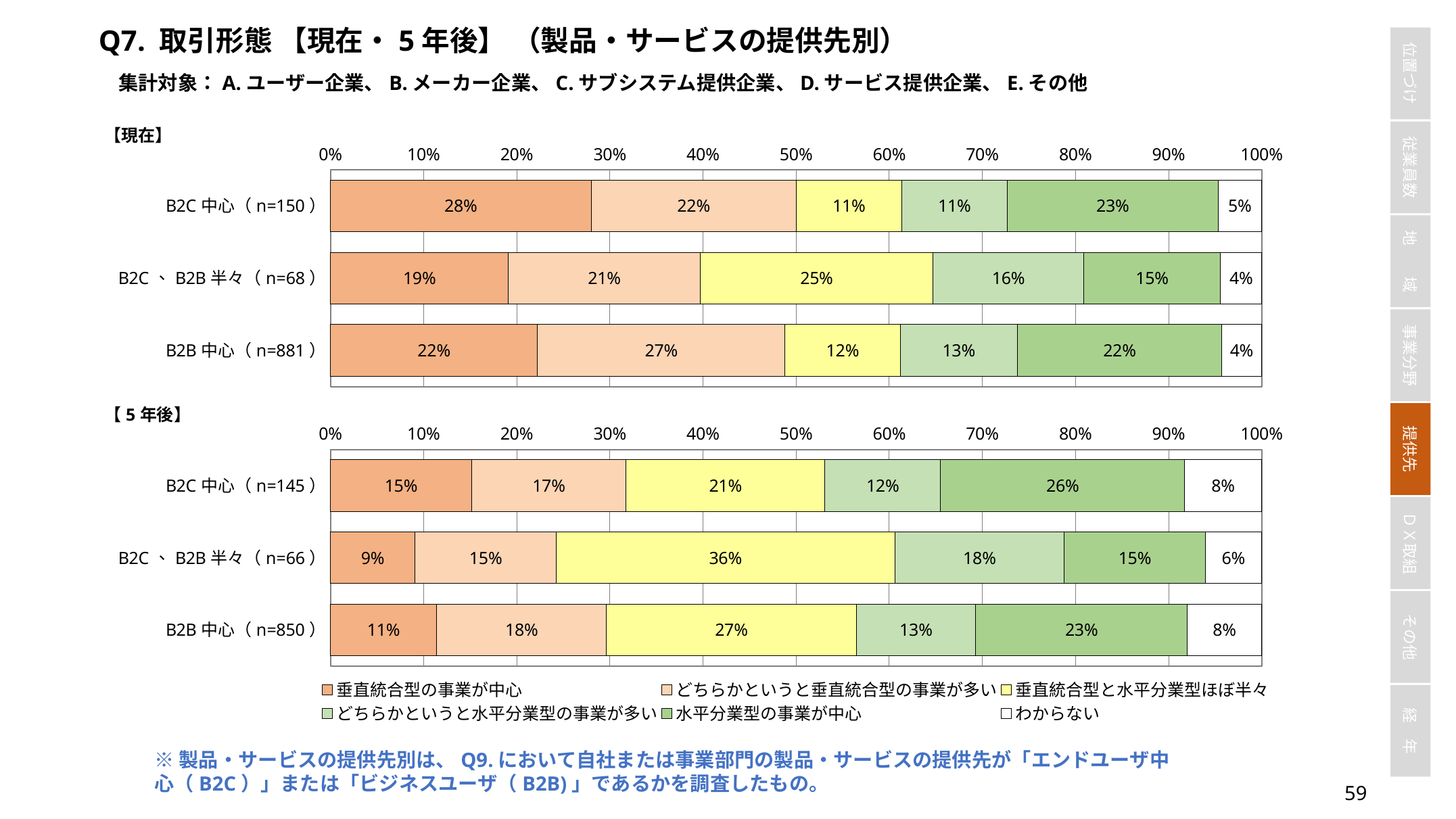
In the 【5年後】 chart, what is the difference between the 垂直統合型と水平分業型ほぼ半々 values for B2C、B2B半々（n=66） and B2B中心（n=850）? 9% In the 【現在】 chart, which category has the lowest value for 垂直統合型の事業が中心? B2C、B2B半々（n=68） In the 【5年後】 chart, what is the combined value of 垂直統合型の事業が中心 and どちらかというと垂直統合型の事業が多い for B2C中心（n=145）? 32% Which legend entry is shown in white? わからない In the 【現在】 chart, what is the value of わからない for B2B中心（n=881）? 4% In the 【現在】 chart, which is larger for B2B中心（n=881）: 垂直統合型の事業が中心 or どちらかというと垂直統合型の事業が多い? どちらかというと垂直統合型の事業が多い How many categories are shown in the 【5年後】 chart? 3 What kind of chart is the 【現在】 chart? Stacked bar chart In the 【現在】 chart, what is the value of 垂直統合型の事業が中心 for B2C中心（n=150）? 28% In the 【5年後】 chart, what is the value of 垂直統合型と水平分業型ほぼ半々 for B2C、B2B半々（n=66）? 36% How many series does the legend list? 6 In the 【5年後】 chart, which category has the highest value for 水平分業型の事業が中心? B2C中心（n=145）